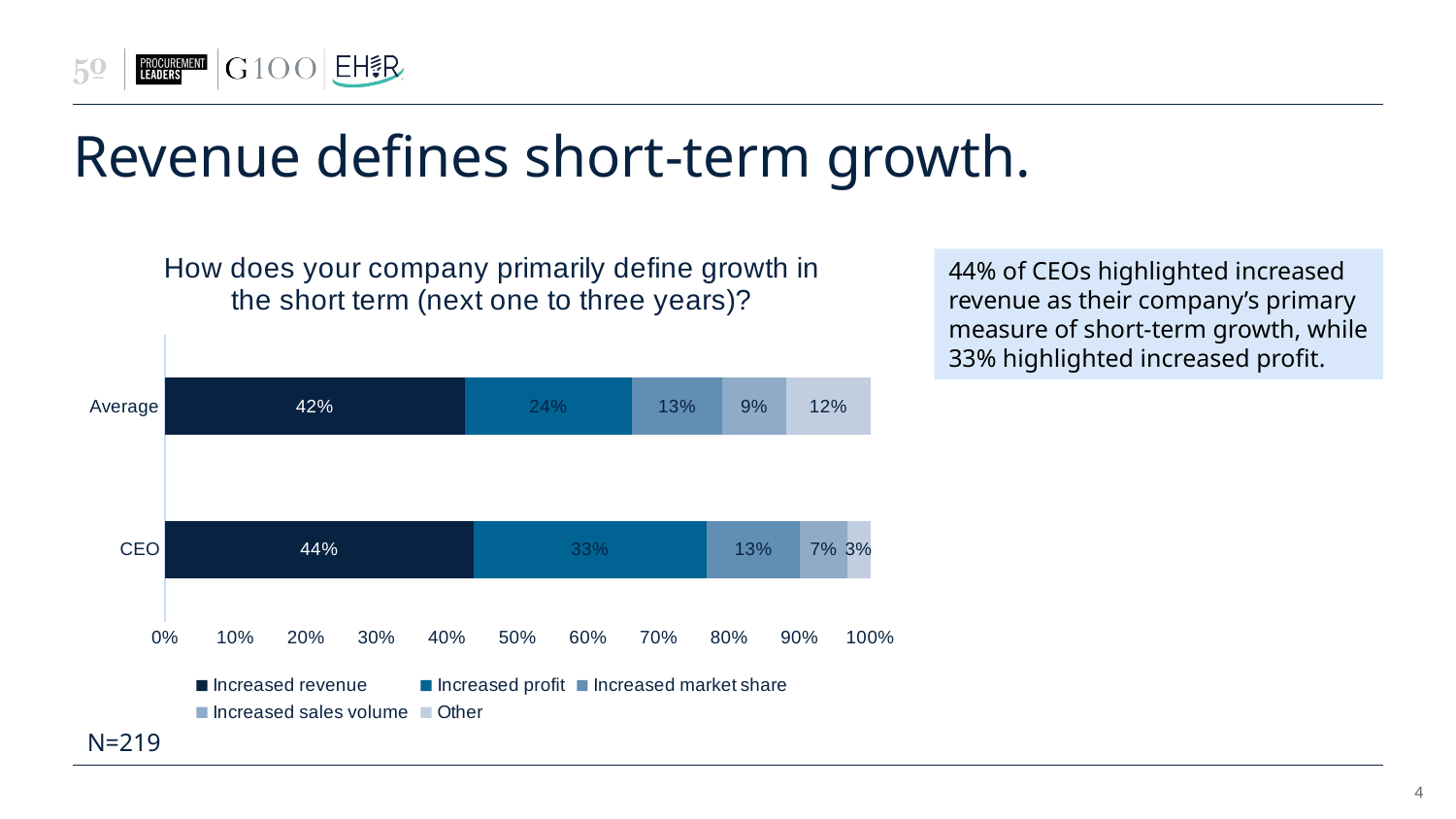
Which series has the largest share in the CEO bar? Increased revenue What is the difference between the Increased profit values for CEO and Average? 9% How many series does the legend list? 5 Which series has the smallest share in the CEO bar? Other What type of chart is shown? Stacked bar chart Which is larger: Increased revenue for CEO or Increased revenue for Average? CEO What is the title of the chart? How does your company primarily define growth in the short term (next one to three years)? How many categories are shown on the vertical axis? 2 What percentage of the Average bar is Increased revenue? 42% What percentage of the CEO bar is Increased profit? 33% What is the value for Other in the CEO bar? 3% What is the value for Increased sales volume in the Average bar? 9%